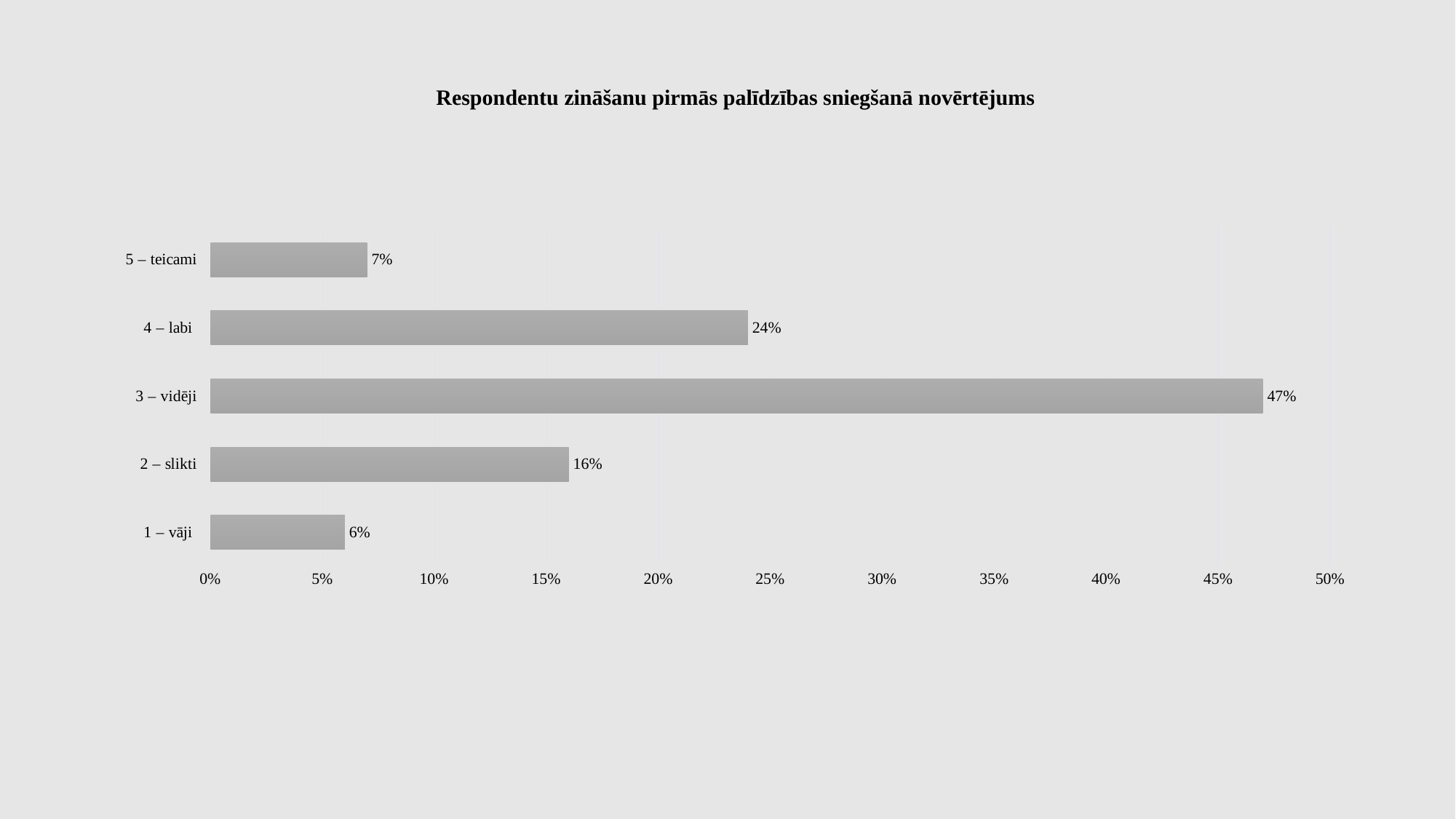
What is the value for "4 – labi"? 24% What is the value for "1 – vāji"? 6% Which category has the lowest value? 1 – vāji Which category has the highest value? 3 – vidēji What kind of chart is shown on the slide? bar chart What is the title of the chart? Respondentu zināšanu pirmās palīdzības sniegšanā novērtējums What is the difference between the values for "3 – vidēji" and "4 – labi"? 23% Is the value for "4 – labi" greater or less than 20%? greater What is the value for "3 – vidēji"? 47% What is the value for "2 – slikti"? 16% How many categories are shown in the chart? 5 Which is larger, the value for "2 – slikti" or the value for "5 – teicami"? 2 – slikti